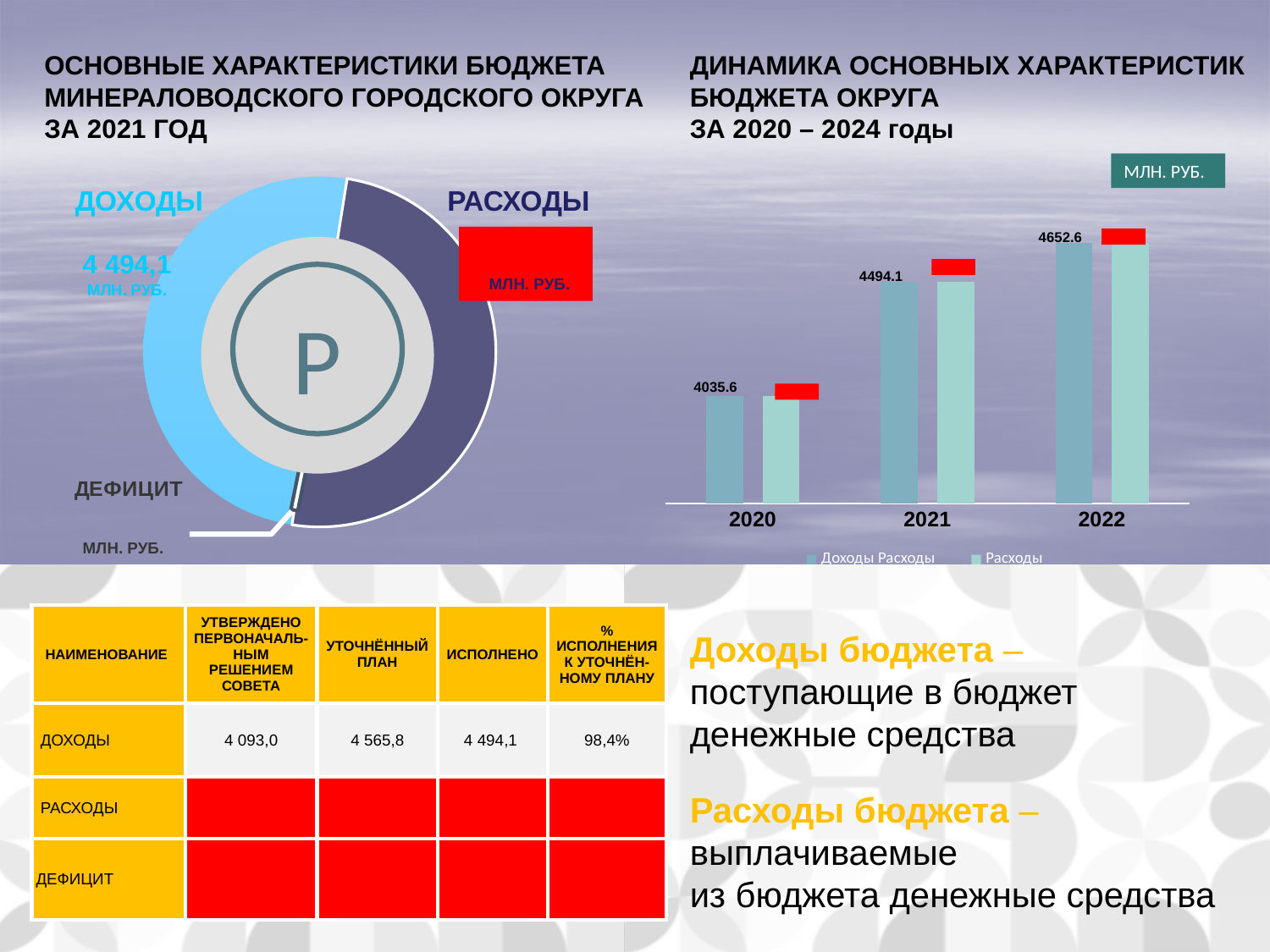
In the bar chart on the right, which year has the lowest Доходы value? 2020 In the bar chart on the right, what is the value of Доходы for 2021? 4494.1 What unit is shown in the label above the bar chart on the right? МЛН. РУБ. How many years are shown on the x axis of the bar chart on the right? 3 In the bar chart on the right, what is the difference between the Доходы values for 2022 and 2020? 617.0 In the bar chart on the right, what is the value of Доходы for 2022? 4652.6 In the bar chart on the right, do the Доходы values rise or fall from 2020 to 2022? rise In the bar chart on the right, what is the value of Доходы for 2020? 4035.6 In the bar chart on the right, which year has the larger Доходы value, 2021 or 2022? 2022 What kind of chart is shown on the right side of the slide? bar chart In the bar chart on the right, what is the difference between the Доходы values for 2021 and 2020? 458.5 In the bar chart on the right, which year has the highest Доходы value? 2022